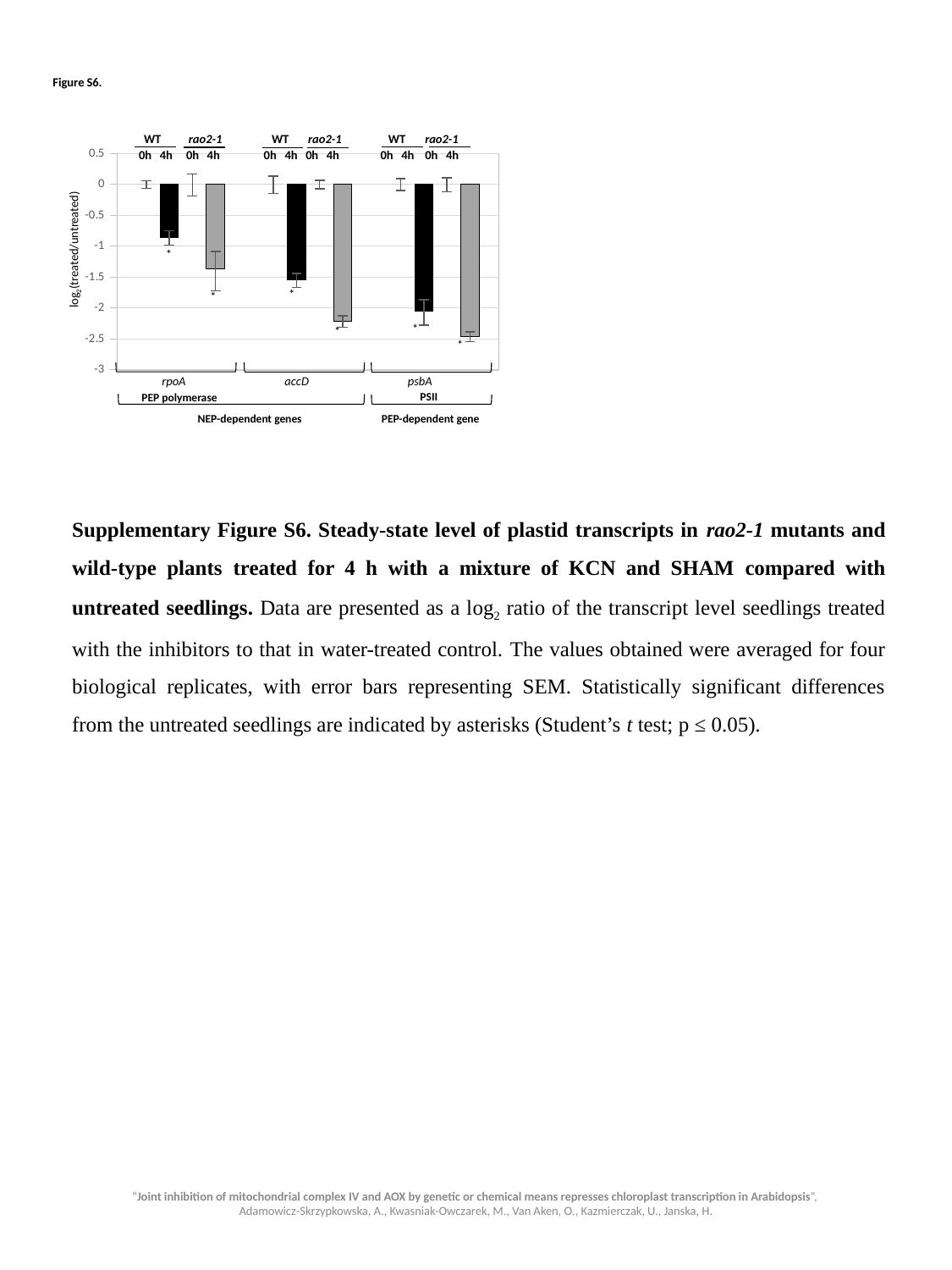
How many genes are shown along the x axis of the chart? 3 Is the value for rao2-1 4h for psbA greater or less than -2? less Is the value for rao2-1 4h for accD greater or less than -2? less What kind of chart is shown on the slide? bar chart For accD, which bar is lower: WT 4h or rao2-1 4h? rao2-1 4h Which bar in the chart has the lowest value? psbA rao2-1 4h Is the value for WT 4h for rpoA greater or less than -0.5? less Which gene is labelled as the PEP-dependent gene in the chart? psbA For rpoA, which bar is lower: WT 4h or rao2-1 4h? rao2-1 4h What is the label of the y axis of the chart? log2(treated/untreated)